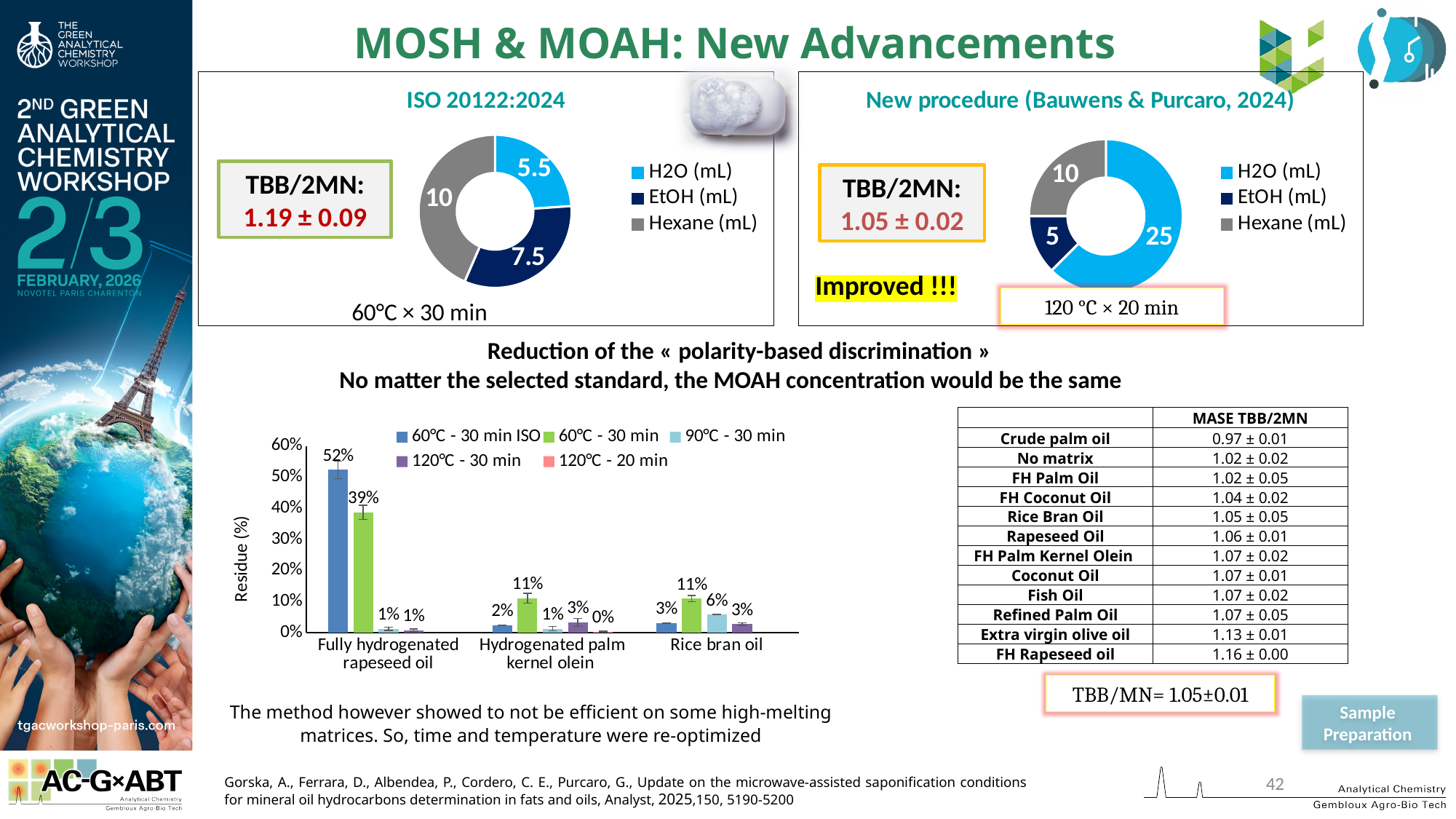
In the ISO 20122:2024 donut chart, what is the value for H2O (mL)? 5.5 In the New procedure (Bauwens & Purcaro, 2024) donut chart, what share of the total volume is H2O? 62.5% In the ISO 20122:2024 donut chart, what is the difference between the Hexane and H2O values? 4.5 In the New procedure (Bauwens & Purcaro, 2024) donut chart, which solvent has the smallest volume? EtOH (mL) How many series does the legend of the Residue (%) bar chart list? 5 In the Residue (%) bar chart, what is the difference between the 60℃ - 30 min ISO and 60℃ - 30 min values for Fully hydrogenated rapeseed oil? 13% In the New procedure (Bauwens & Purcaro, 2024) donut chart, what is the value for H2O (mL)? 25 In the Residue (%) bar chart, what is the value for Fully hydrogenated rapeseed oil under 60℃ - 30 min ISO? 52% In the Residue (%) bar chart, for Rice bran oil, which is larger: the 90℃ - 30 min value or the 120℃ - 30 min value? 90℃ - 30 min What type of chart is the Residue (%) chart at the bottom of the slide? bar chart In the ISO 20122:2024 donut chart, which solvent has the largest volume? Hexane (mL) How many oil categories are shown on the x axis of the Residue (%) bar chart? 3